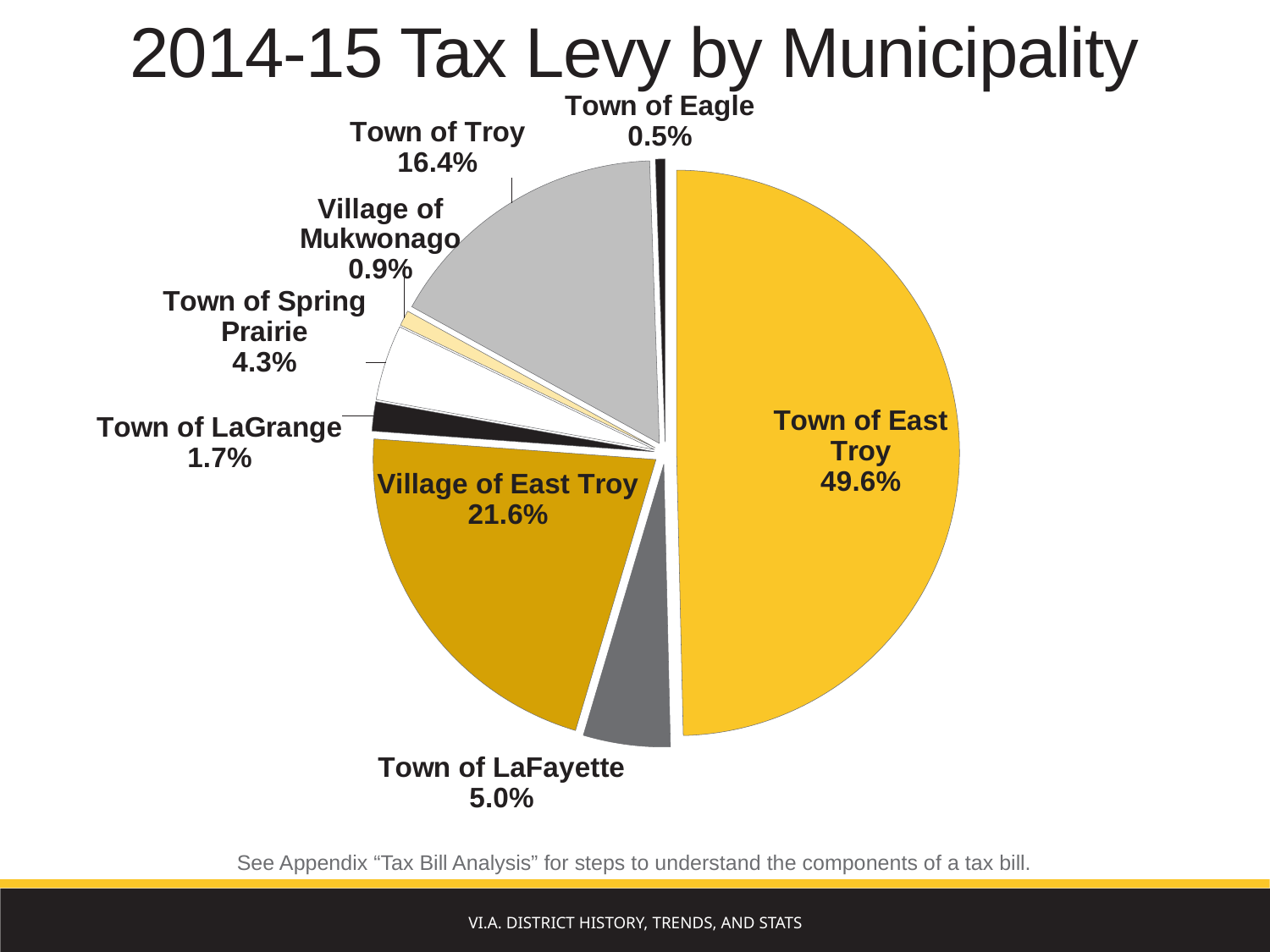
What is the Town of Troy's share of the tax levy? 16.4% What share of the 2014-15 tax levy comes from the Town of East Troy? 49.6% Which has a larger share of the tax levy, the Town of LaFayette or the Town of Spring Prairie? Town of LaFayette Which municipality has the smallest share of the tax levy? Town of Eagle What percentage of the tax levy is attributed to the Town of Spring Prairie? 4.3% What is the difference in percentage points between the Town of East Troy and the Village of East Troy shares? 28.0% What is the title of the chart? 2014-15 Tax Levy by Municipality What is the combined share of the Town of LaGrange and the Village of Mukwonago? 2.6% What share of the tax levy does the Village of East Troy account for? 21.6% How many municipalities are shown in the pie chart? 8 Which municipality has the largest share of the 2014-15 tax levy? Town of East Troy What type of chart is used on this slide? Pie chart